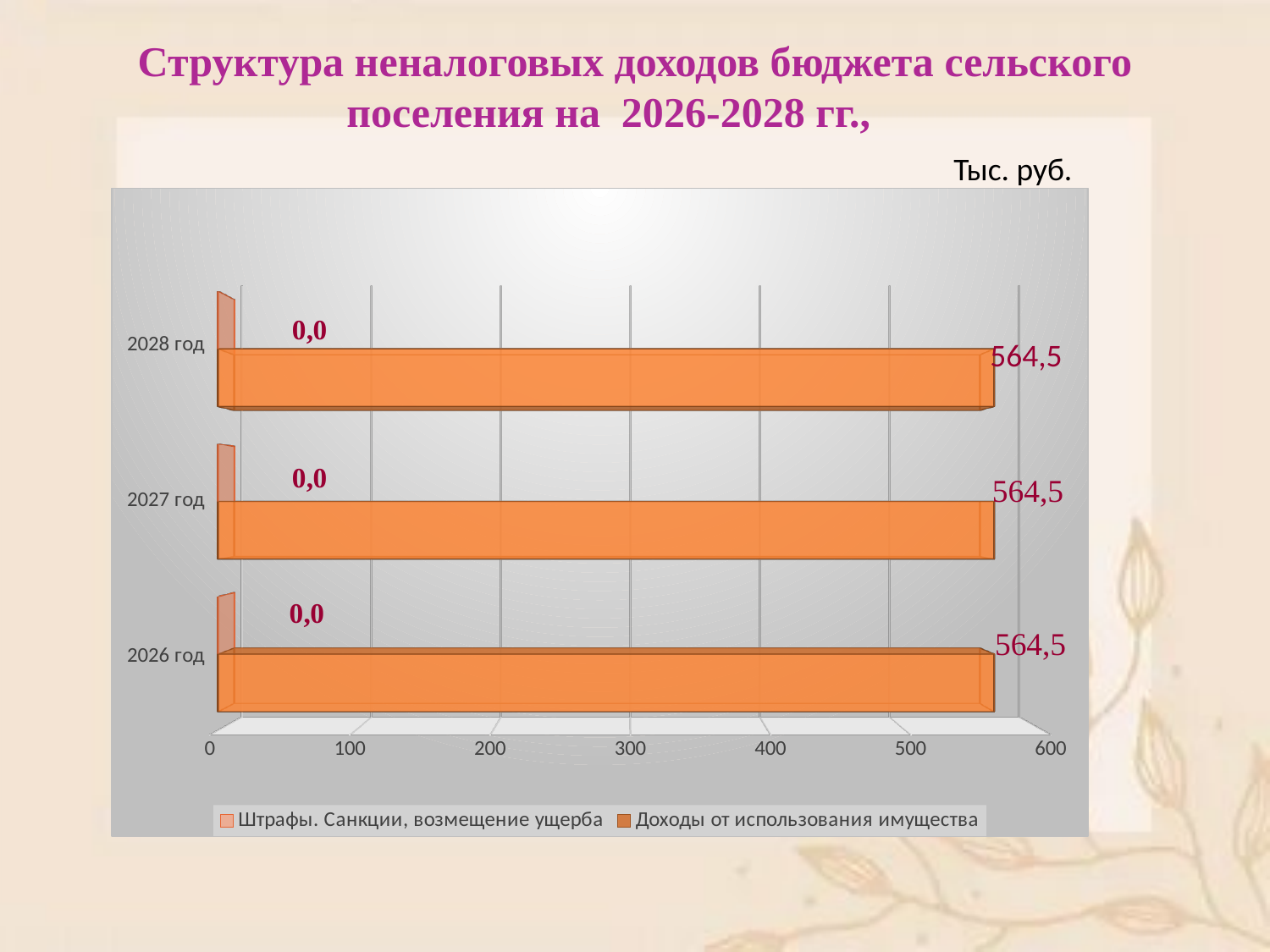
How many year categories are shown on the chart? 3 What is the value for "Штрафы. Санкции, возмещение ущерба" in 2026 год? 0,0 Does the value for "Доходы от использования имущества" rise, fall or stay the same from 2026 год to 2028 год? stays the same Is the value for "Доходы от использования имущества" in 2026 год greater or less than 500? greater Which series has the larger value in 2027 год: "Штрафы. Санкции, возмещение ущерба" or "Доходы от использования имущества"? Доходы от использования имущества What is the value for "Штрафы. Санкции, возмещение ущерба" in 2027 год? 0,0 What is the difference between "Доходы от использования имущества" and "Штрафы. Санкции, возмещение ущерба" in 2028 год? 564,5 What unit of measurement is indicated above the chart? Тыс. руб. How many series does the legend list? 2 What is the value for "Доходы от использования имущества" in 2028 год? 564,5 What kind of chart is shown on the slide? bar chart What is the value for "Доходы от использования имущества" in 2026 год? 564,5